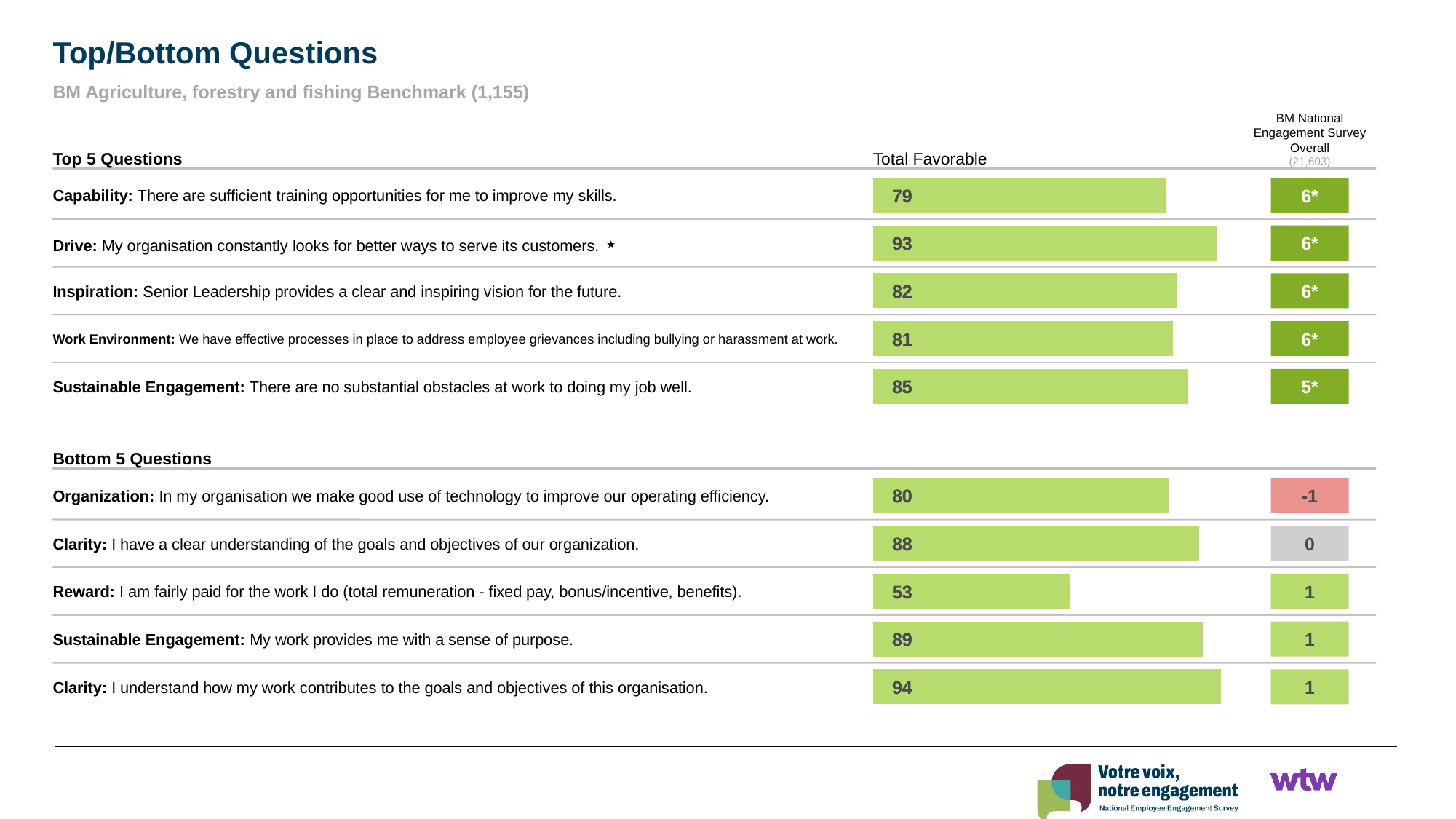
In the Top 5 Questions chart, what is the Total Favorable value for the Capability question? 79 In the Top 5 Questions chart, which question has the highest Total Favorable value? Drive In the Top 5 Questions chart, what is the difference in Total Favorable between the Drive question and the Capability question? 14 In the Bottom 5 Questions chart, what is the BM National Engagement Survey Overall comparison value for the Organization question? -1 In the Top 5 Questions chart, what is the Total Favorable value for the Drive question? 93 What kind of chart is used to show Total Favorable on this slide? Bar chart In the Bottom 5 Questions chart, which question has the lowest Total Favorable value? Reward In the Bottom 5 Questions chart, what is the Total Favorable value for the Reward question? 53 How many questions are shown in the Bottom 5 Questions chart? 5 In the Bottom 5 Questions chart, which has a higher Total Favorable value: the Organization question or the Reward question? Organization What is the benchmark named in the subtitle of the slide? BM Agriculture, forestry and fishing Benchmark (1,155) In the Top 5 Questions chart, what is the BM National Engagement Survey Overall comparison value for the Sustainable Engagement question? 5*